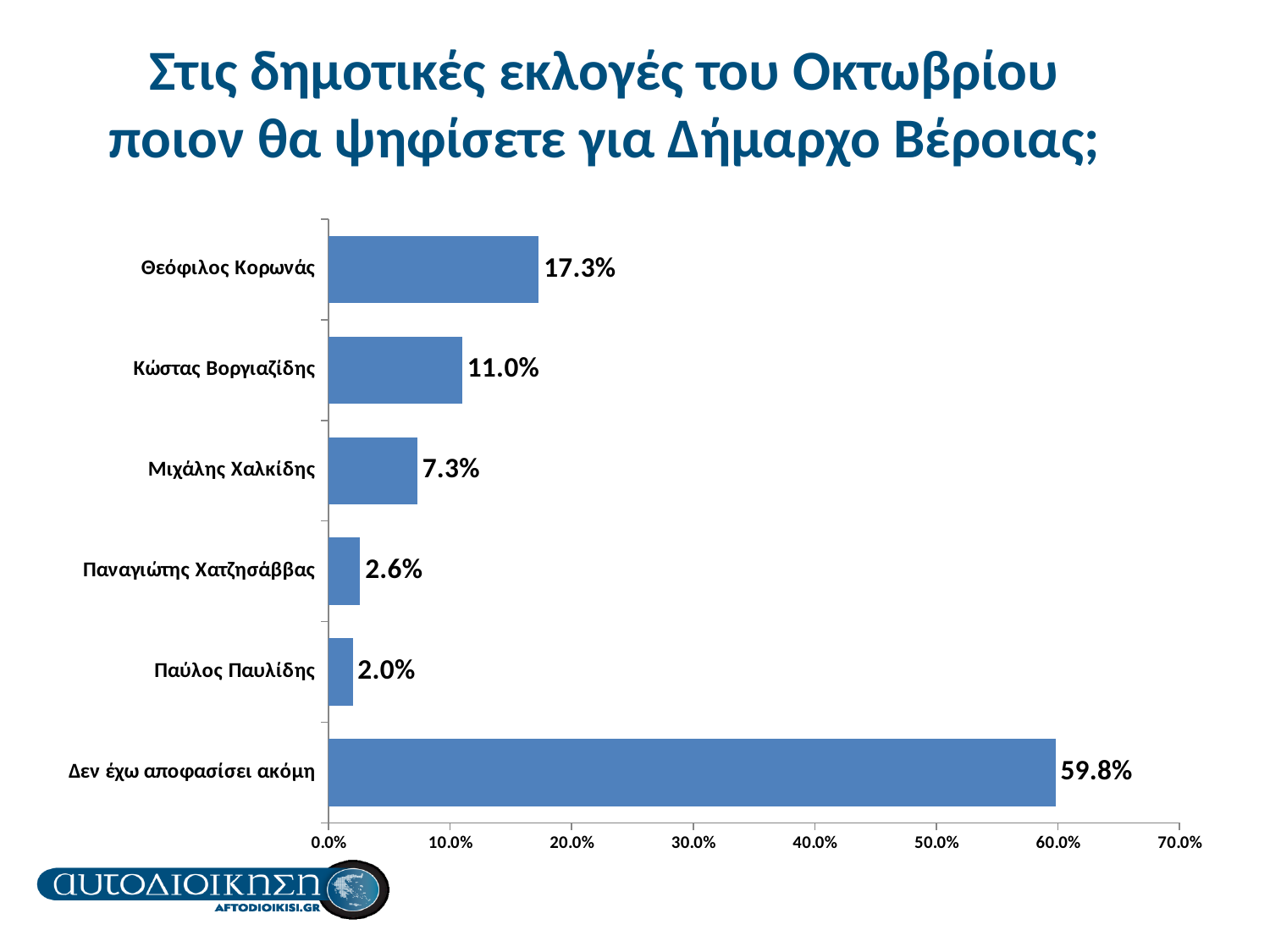
What is the value for Μιχάλης Χαλκίδης? 7.3% What is the value for Δεν έχω αποφασίσει ακόμη? 59.8% What kind of chart is shown on the slide? bar chart Which candidate has the highest value among the named candidates? Θεόφιλος Κορωνάς What is the value for Θεόφιλος Κορωνάς? 17.3% What is the difference between the values for Θεόφιλος Κορωνάς and Κώστας Βοργιαζίδης? 6.3% Which category has the highest value? Δεν έχω αποφασίσει ακόμη Is the value for Δεν έχω αποφασίσει ακόμη greater or less than 50.0%? greater How many categories are shown in the chart? 6 What is the value for Κώστας Βοργιαζίδης? 11.0% Which category has the lowest value? Παύλος Παυλίδης Which is larger, the value for Παναγιώτης Χατζησάββας or the value for Παύλος Παυλίδης? Παναγιώτης Χατζησάββας